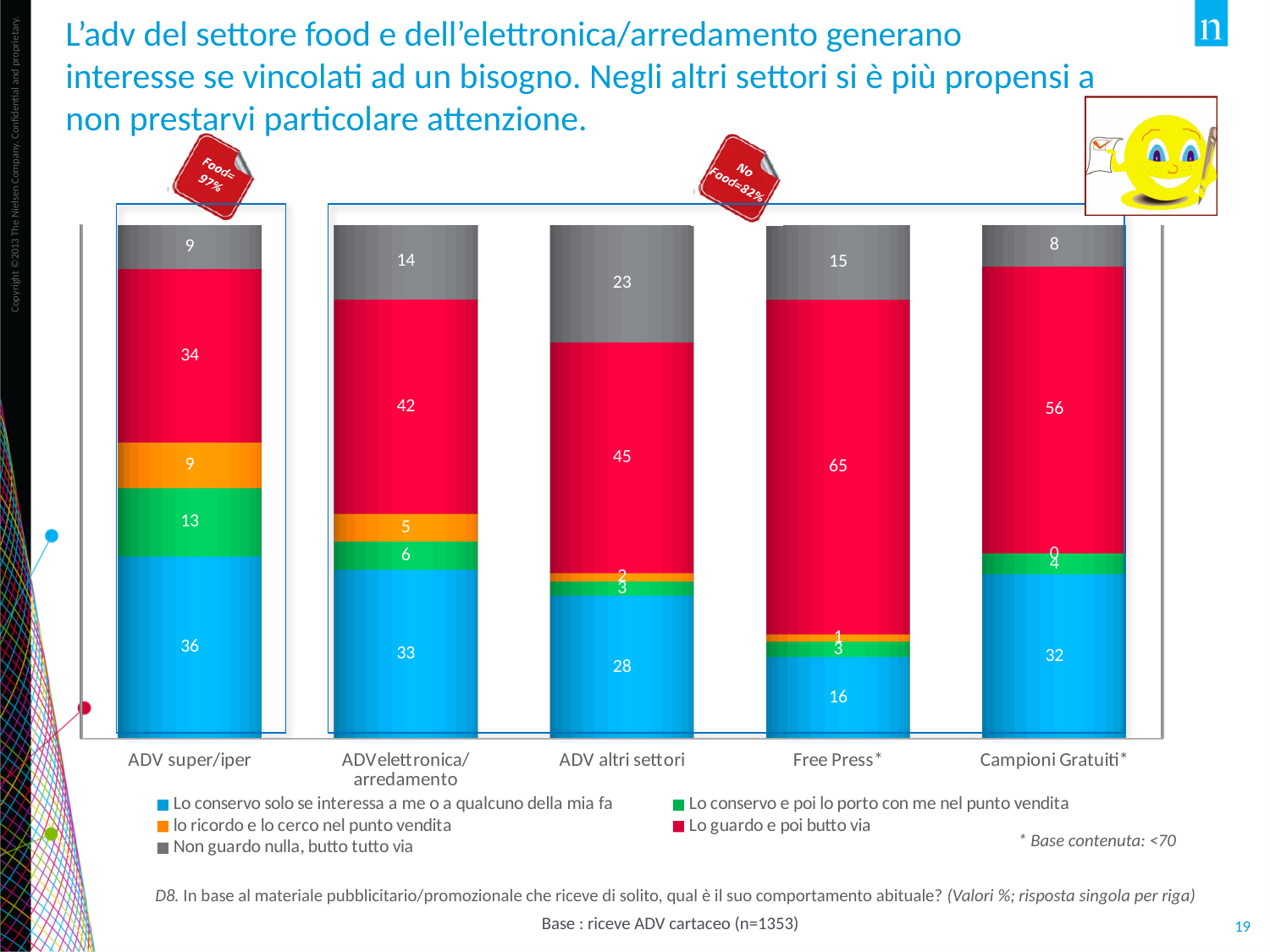
How many categories are shown on the x axis of the chart? 5 What is the value of "Non guardo nulla, butto tutto via" for ADV altri settori? 23 Which category has the lowest value for "Lo conservo solo se interessa a me o a qualcuno della mia fa"? Free Press* How many series does the legend list? 5 Which has the larger value for "Non guardo nulla, butto tutto via": ADV super/iper or ADV altri settori? ADV altri settori What is the total of the stacked bar for ADV elettronica/arredamento? 100 What is the difference in "Lo guardo e poi butto via" between Campioni Gratuiti* and ADV super/iper? 22 What is the value of "lo ricordo e lo cerco nel punto vendita" for Campioni Gratuiti*? 0 What is the value of "Lo conservo solo se interessa a me o a qualcuno della mia fa" for ADV super/iper? 36 Which category has the highest value for "Lo guardo e poi butto via"? Free Press* What kind of chart is shown on the slide? Stacked bar chart What is the value of "Lo guardo e poi butto via" for Free Press*? 65